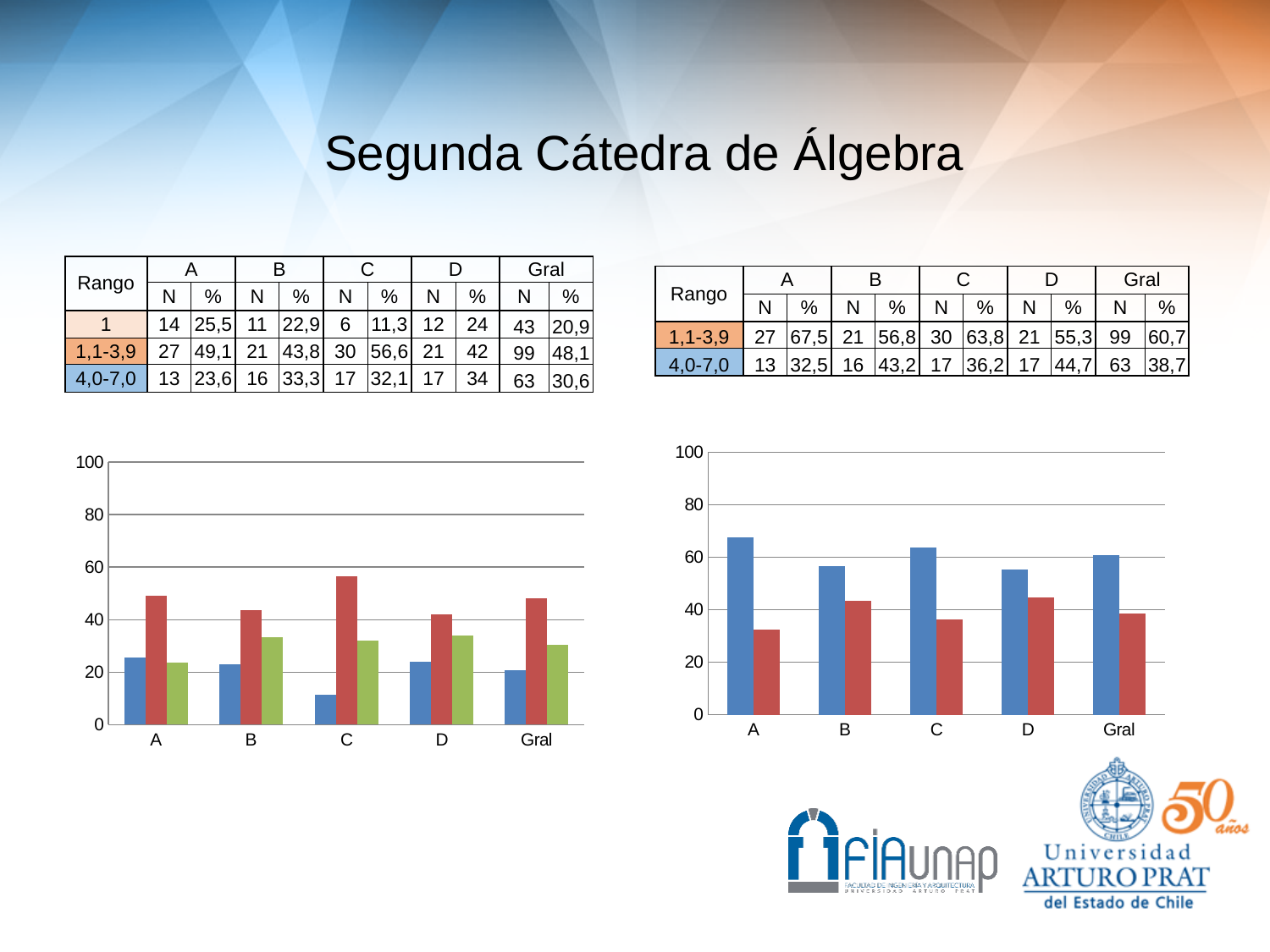
In the chart on the right, is the blue bar for A greater or less than 60? greater In the chart on the left, which category has the shortest blue bar? C How many bars are plotted for each category in the chart on the right? 2 In the chart on the right, which category has the tallest blue bar? A How many categories are shown on the x axis of the chart on the left? 5 In the chart on the left, which category has the tallest red bar? C How many bars are plotted for each category in the chart on the left? 3 What kind of chart is the chart on the right of the slide? bar chart What kind of chart is the chart on the left of the slide? bar chart In the chart on the left, is the red bar for C greater or less than 40? greater In the chart on the right, which category has the shortest red bar? A How many categories are shown on the x axis of the chart on the right? 5